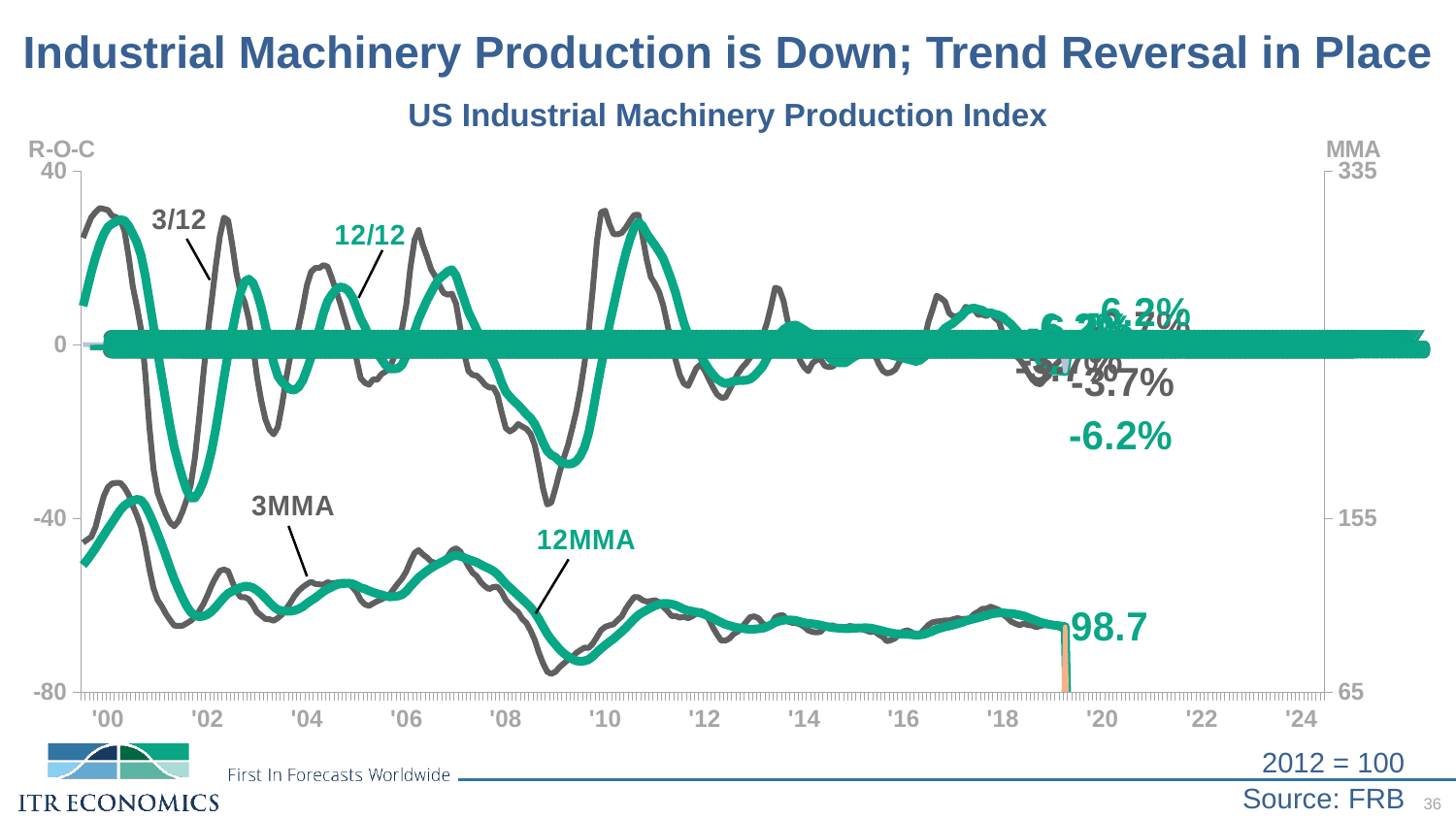
What is the difference between the latest 3/12 value (-3.7%) and the latest 12/12 value (-6.2%)? 2.5 percentage points What is the latest value printed for the 12MMA line? 98.7 Which is lower, the latest 12/12 value or the latest 3/12 value? 12/12 What is the latest 3/12 rate-of-change value printed on the chart? -3.7% What kind of chart is shown on the slide? line chart What is the latest 12/12 rate-of-change value printed on the chart? -6.2% What source is cited for the chart data? FRB How many data series are labeled on the chart? 4 Is the latest 12MMA value greater or less than 155 on the MMA axis? less What is the title of the chart? US Industrial Machinery Production Index Does the 12MMA line rise or fall between '08 and '09? fall Is the 3MMA value at its low point around '09 greater or less than 155 on the MMA axis? less